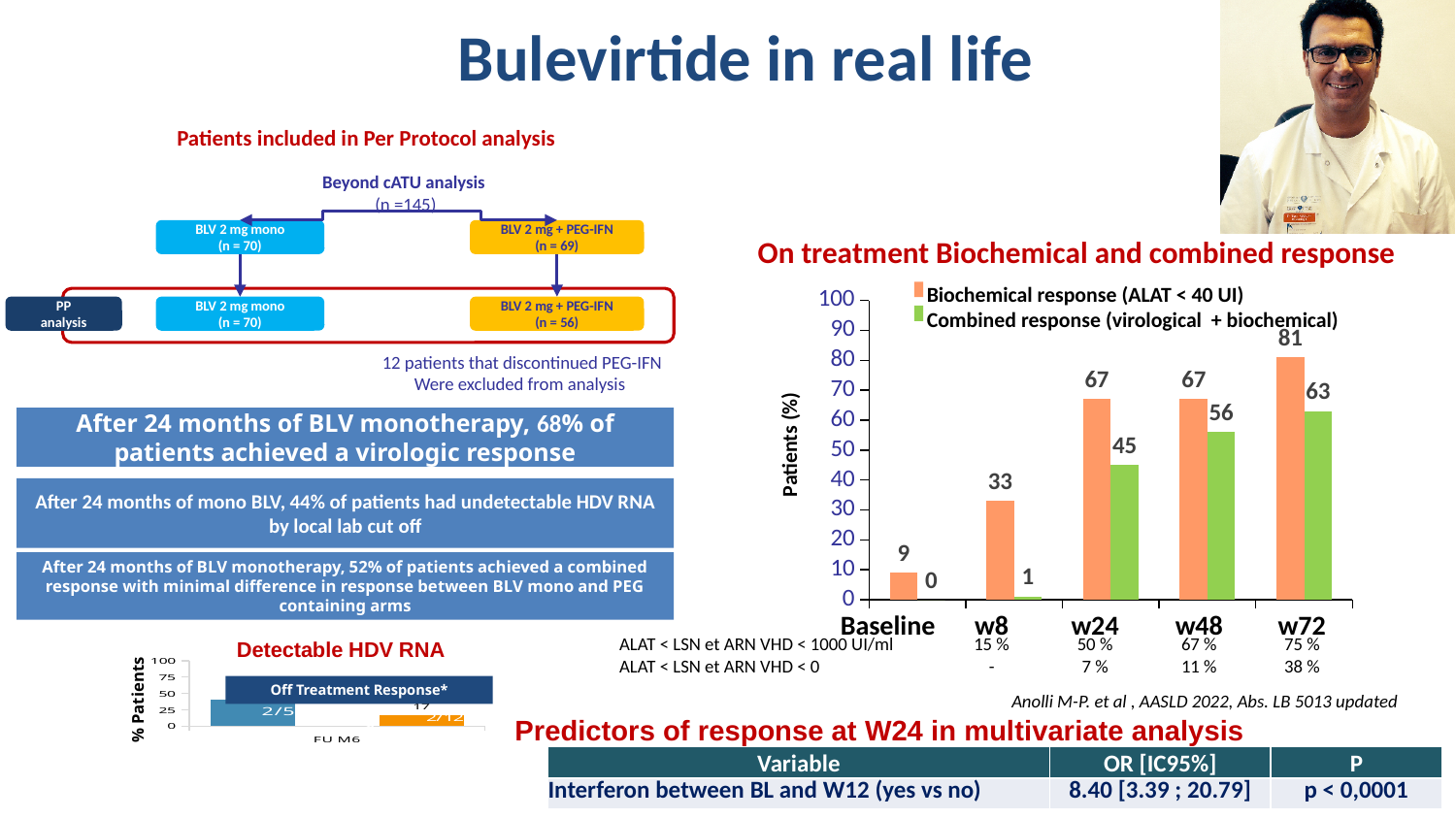
In the 'On treatment Biochemical and combined response' chart, which is larger at w8: the biochemical response or the combined response? Biochemical response In the 'On treatment Biochemical and combined response' chart, at which time point is the combined response lowest? Baseline What type of chart is the 'On treatment Biochemical and combined response' chart? Bar chart In the 'On treatment Biochemical and combined response' chart, what is the difference between the combined response at w48 and at w24? 11 In the 'On treatment Biochemical and combined response' chart, what is the biochemical response value at Baseline? 9 In the 'On treatment Biochemical and combined response' chart, does the combined response rise or fall from Baseline to w72? Rise In the 'On treatment Biochemical and combined response' chart, what is the combined response value at w48? 56 How many series does the legend of the 'On treatment Biochemical and combined response' chart list? 2 In the 'On treatment Biochemical and combined response' chart, what is the difference between the biochemical and combined response at w72? 18 In the 'On treatment Biochemical and combined response' chart, at which time point is the biochemical response highest? w72 In the 'On treatment Biochemical and combined response' chart, what is the biochemical response value at w24? 67 How many time points are shown on the x axis of the 'On treatment Biochemical and combined response' chart? 5